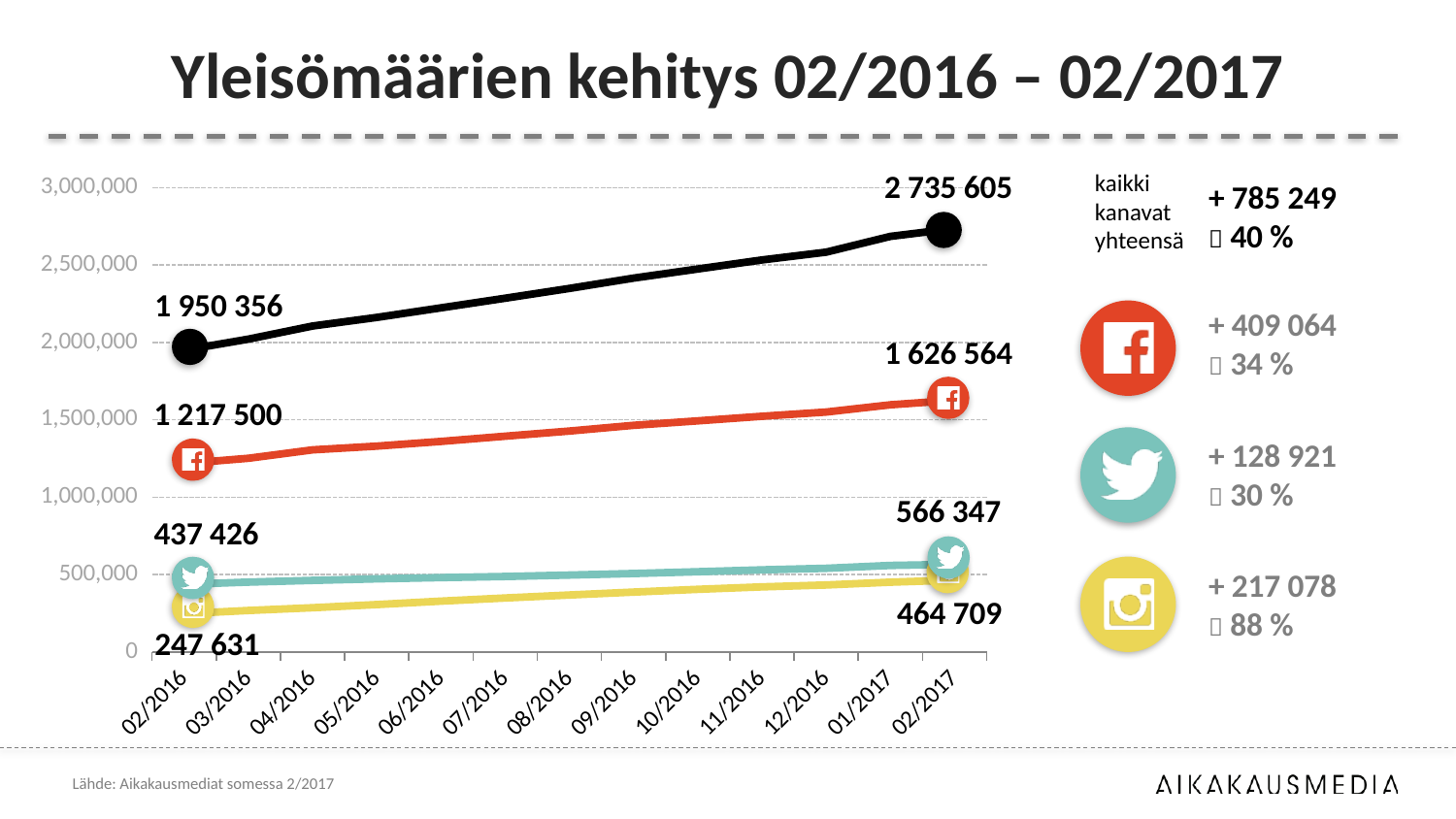
What is the value of the Facebook line at 02/2016? 1 217 500 What is the value of the Twitter line at 02/2017? 566 347 Does the black line rise or fall from 02/2016 to 02/2017? rise At 02/2017, which is larger: the Twitter line or the Instagram line? Twitter What is the difference between the black line's values at 02/2017 and 02/2016? 785 249 What kind of chart is shown on the slide? line chart What is the value of the black line (kaikki kanavat yhteensä) at 02/2017? 2 735 605 Is the value of the Facebook line at 02/2017 greater or less than 1,500,000? greater What is the value of the Instagram line at 02/2016? 247 631 By how much did the Facebook line increase from 02/2016 to 02/2017? 409 064 What is the title of the chart? Yleisömäärien kehitys 02/2016 – 02/2017 How many months are labelled on the x axis? 13